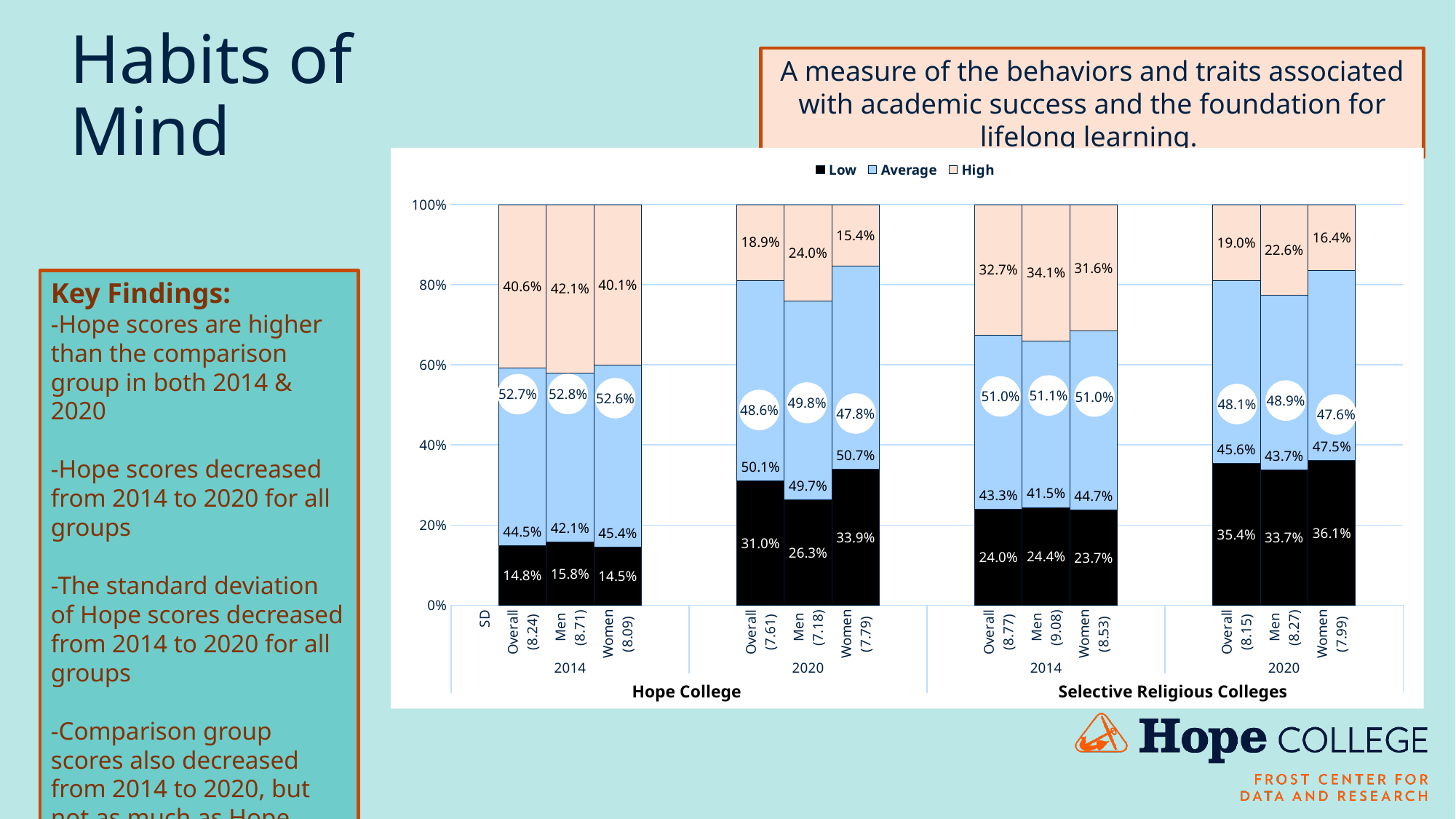
Which colour represents the Low series in the legend? Black Which has the larger High percentage in 2014: Hope College Men or Selective Religious Colleges Men? Hope College Men (42.1%) What SD value is shown for Hope College Overall in 2020? 7.61 Which bar has the highest Low percentage? Selective Religious Colleges Women 2020 (36.1%) How many stacked bars are plotted in the chart? 12 By how many percentage points did the Low share for Hope College Overall change from 2014 (14.8%) to 2020 (31.0%)? 16.2 percentage points How many series does the chart legend list? 3 What is the Average percentage for Selective Religious Colleges Men in 2014? 41.5% What is the Low percentage for Hope College Overall in 2014? 14.8% What kind of chart is shown on the slide? Stacked bar chart What is the High percentage for Hope College Women in 2020? 15.4% Which bar has the lowest High percentage? Hope College Women 2020 (15.4%)